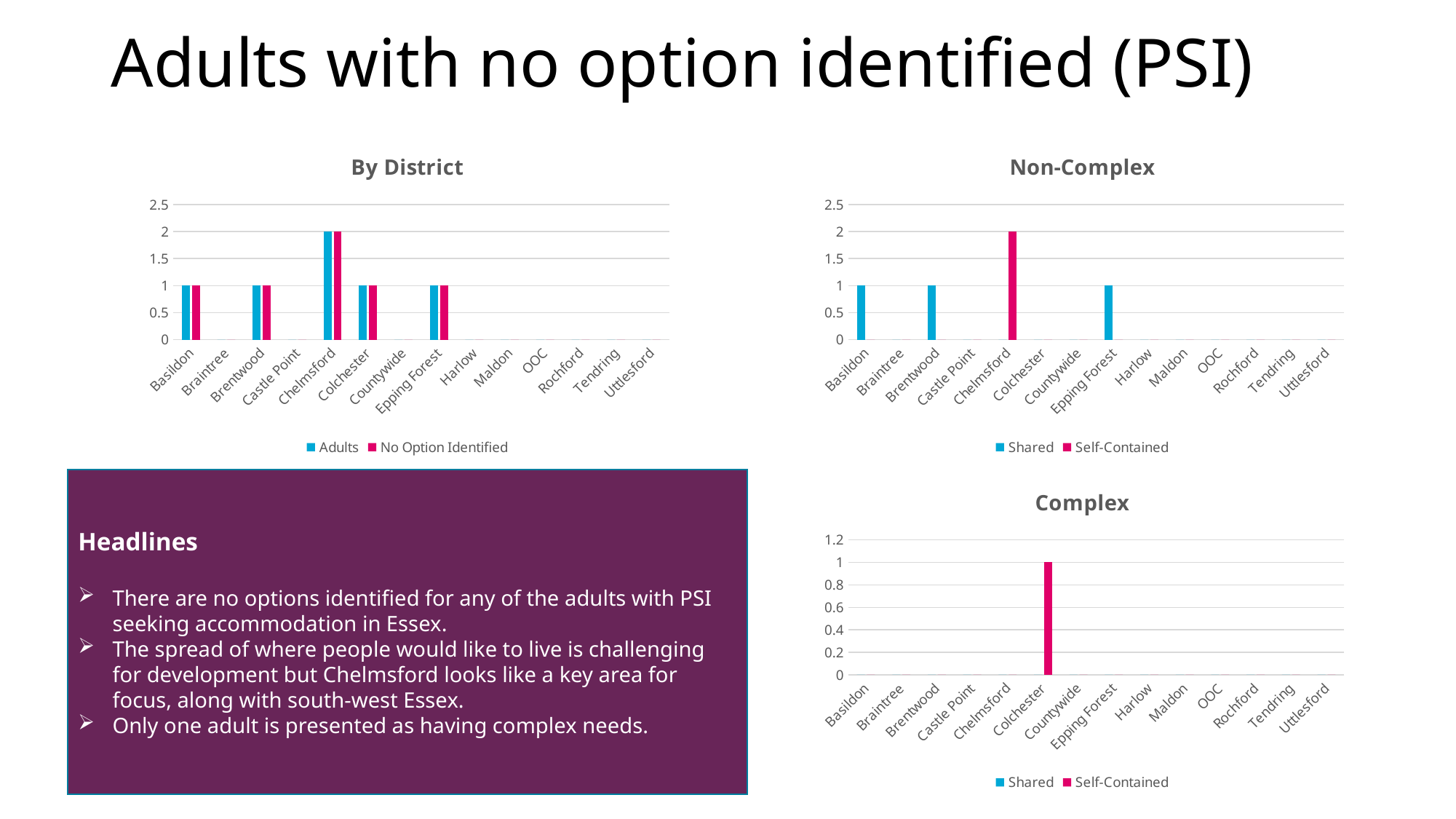
In the By District chart, what is the value for Adults in Chelmsford? 2 In the By District chart, how many districts are shown on the x axis? 14 In the By District chart, what is the difference between the Adults value for Chelmsford and the Adults value for Basildon? 1 In the Complex chart, which district has the highest value? Colchester In the By District chart, how many series does the legend list? 2 In the Non-Complex chart, what is the Self-Contained value for Chelmsford? 2 In the Non-Complex chart, what is the Shared value for Brentwood? 1 What kind of chart is the Non-Complex chart? bar chart In the Complex chart, what is the Self-Contained value for Colchester? 1 What are the two legend entries in the Complex chart? Shared, Self-Contained In the Non-Complex chart, which is larger: the Self-Contained value for Chelmsford or the Shared value for Epping Forest? Self-Contained value for Chelmsford In the By District chart, which district has the highest value for Adults? Chelmsford